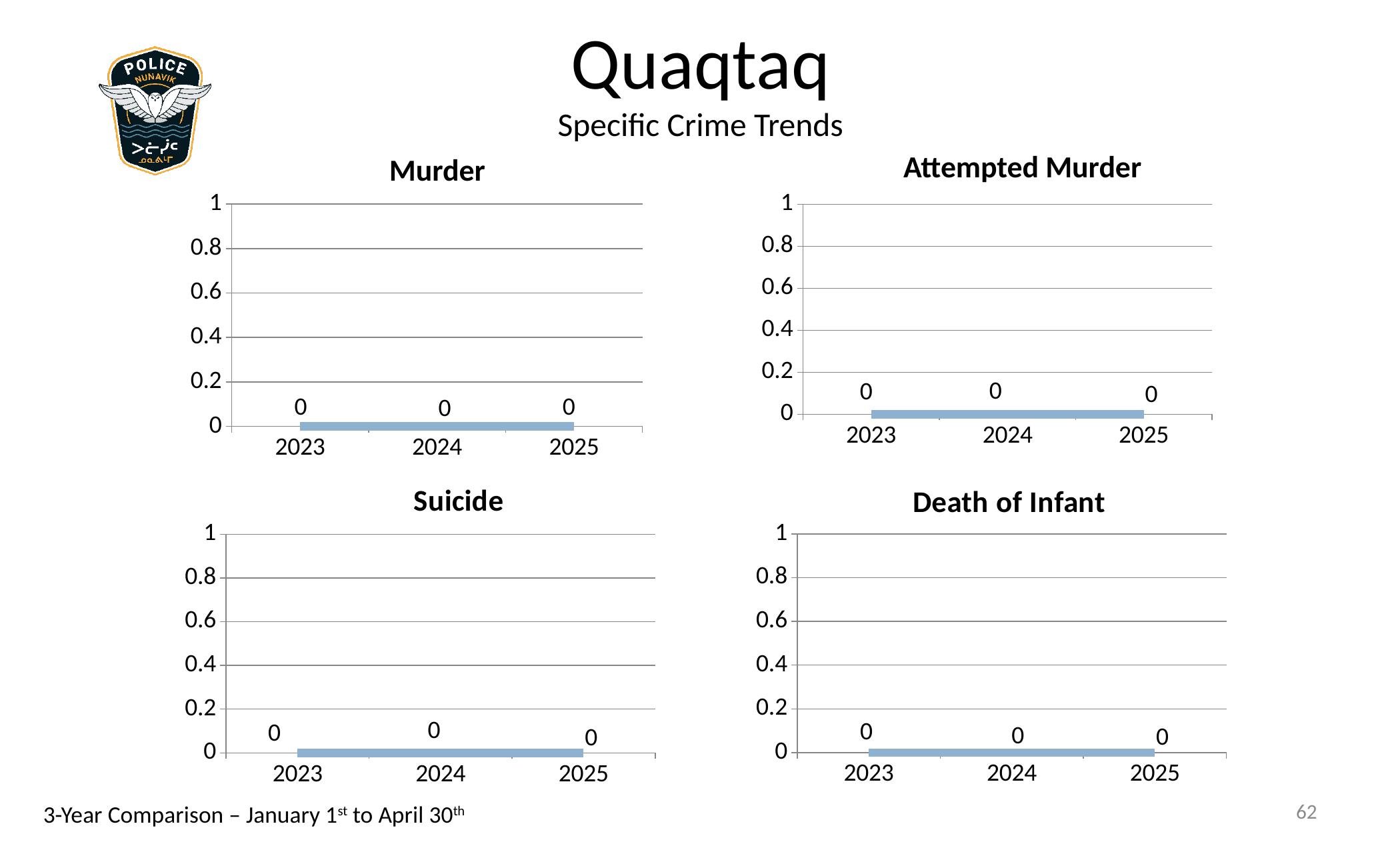
How many years are shown on the x axis of the Murder chart? 3 In the Murder chart, what is the value for 2023? 0 In the Death of Infant chart, what is the value for 2023? 0 How many charts are shown on the slide? 4 In the Attempted Murder chart, is the value for 2025 greater or less than 0.2? less In the Suicide chart, do the values rise, fall, or stay flat from 2023 to 2025? stay flat In the Death of Infant chart, what is the difference between the 2025 and 2023 values? 0 In the Attempted Murder chart, what is the value for 2024? 0 In the Suicide chart, what is the value for 2025? 0 In the Murder chart, what is the value for 2025? 0 In the Suicide chart, what is the difference between the 2023 and 2024 values? 0 How many data points are plotted in the Attempted Murder chart? 3